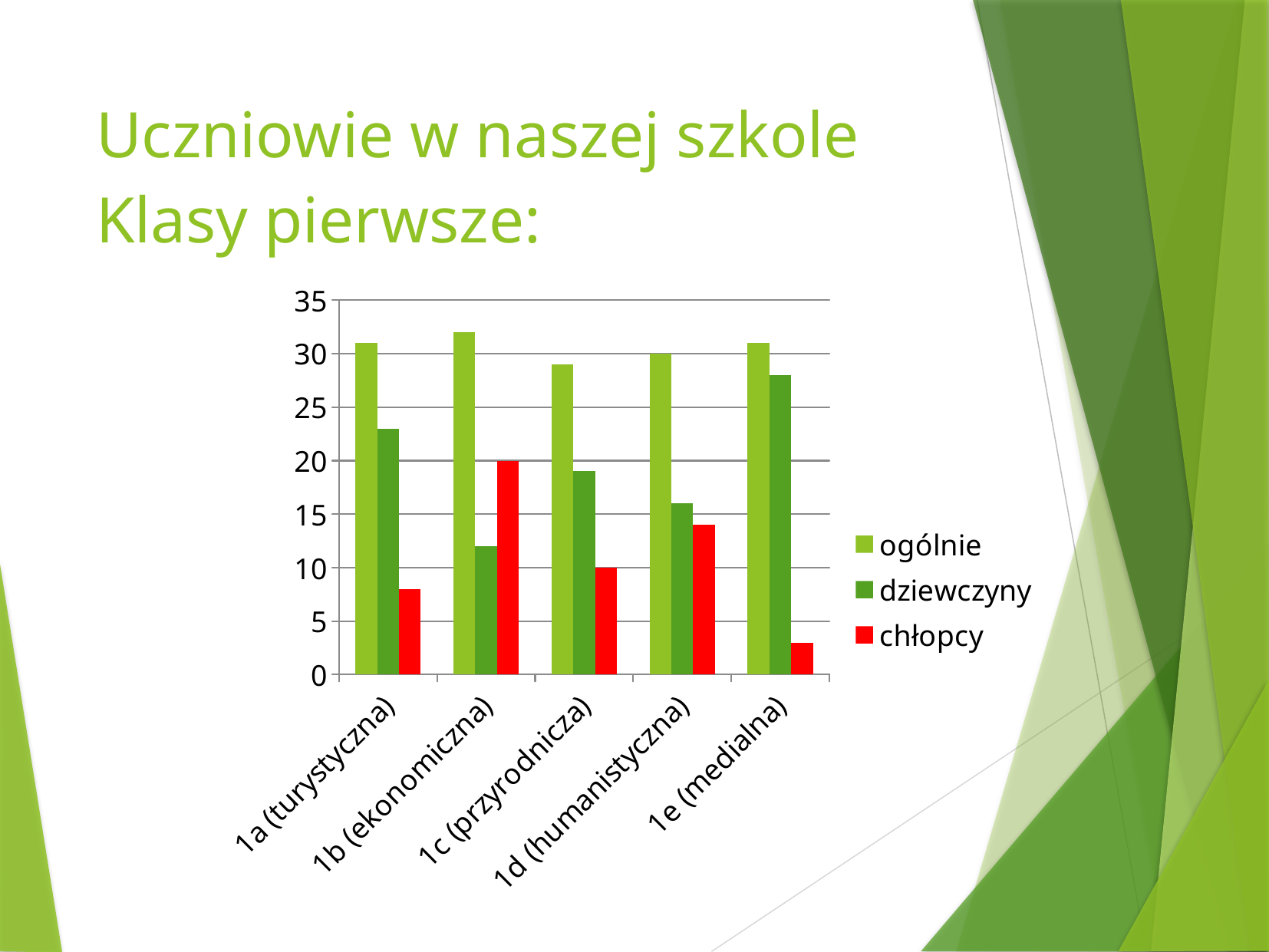
Is the value for chłopcy in 1a (turystyczna) greater or less than 10? less What are the three legend entries of the chart? ogólnie, dziewczyny, chłopcy Which class has the highest value for dziewczyny? 1e (medialna) Which class has the highest value for chłopcy? 1b (ekonomiczna) How many classes are shown on the x axis? 5 Is the value for dziewczyny in 1e (medialna) greater or less than 25? greater What kind of chart is shown on the slide? bar chart For 1b (ekonomiczna), which is larger: dziewczyny or chłopcy? chłopcy For 1a (turystyczna), which is larger: dziewczyny or chłopcy? dziewczyny How many series does the legend list? 3 Which class has the lowest value for chłopcy? 1e (medialna) Which class has the lowest value for dziewczyny? 1b (ekonomiczna)